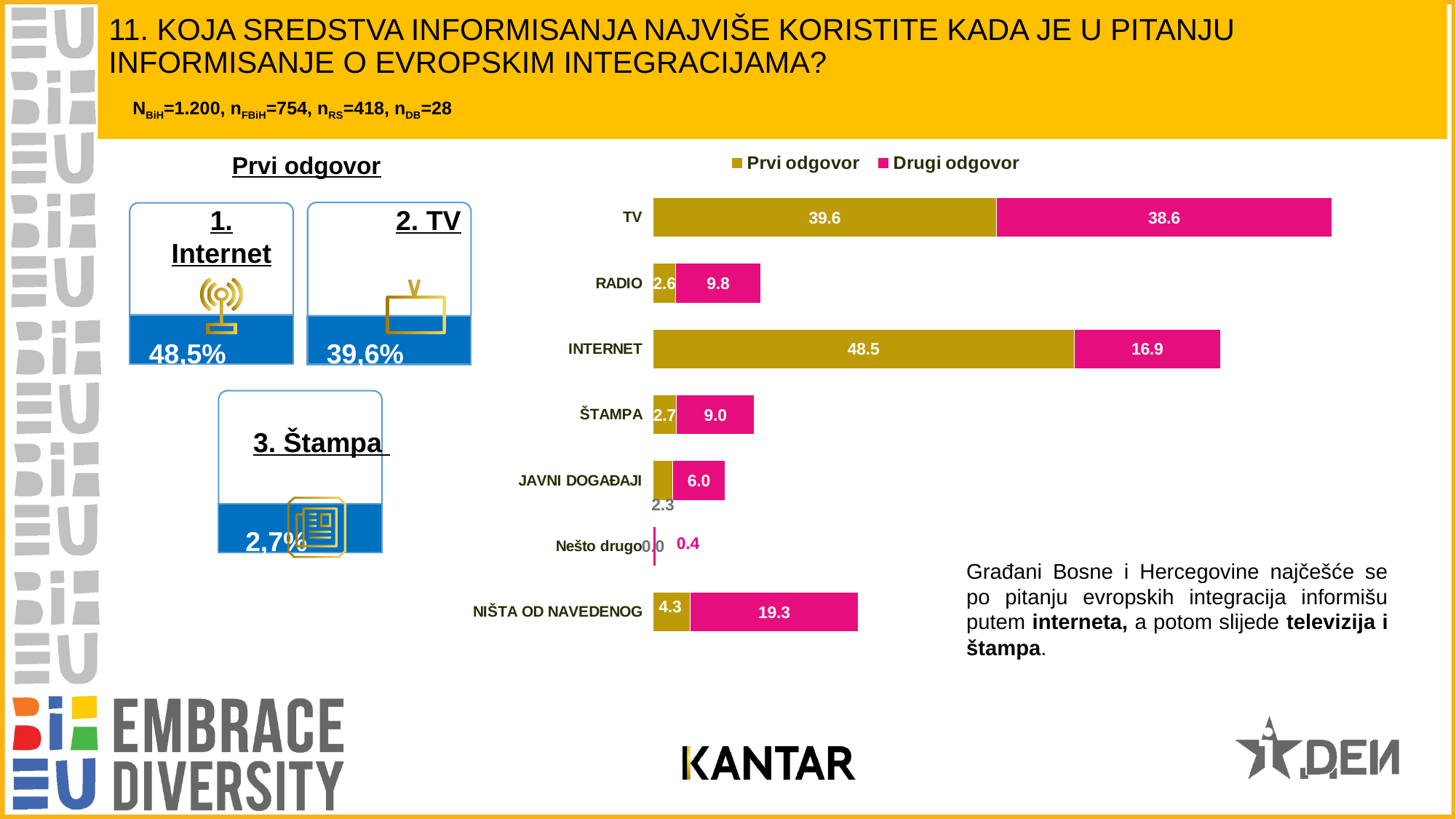
Which is larger: the Drugi odgovor value for RADIO or for ŠTAMPA? RADIO What is the total of the stacked bar for TV? 78.2 Which series is shown in pink in the legend? Drugi odgovor What kind of chart is shown on the slide? Stacked bar chart What is the Prvi odgovor value for INTERNET? 48.5 What is the Drugi odgovor value for NIŠTA OD NAVEDENOG? 19.3 How many series does the legend list? 2 Which category has the highest Prvi odgovor value? INTERNET What is the difference between the Prvi odgovor values for INTERNET and TV? 8.9 Which category has the lowest Drugi odgovor value? Nešto drugo What is the Drugi odgovor value for TV? 38.6 How many categories are shown in the bar chart? 7